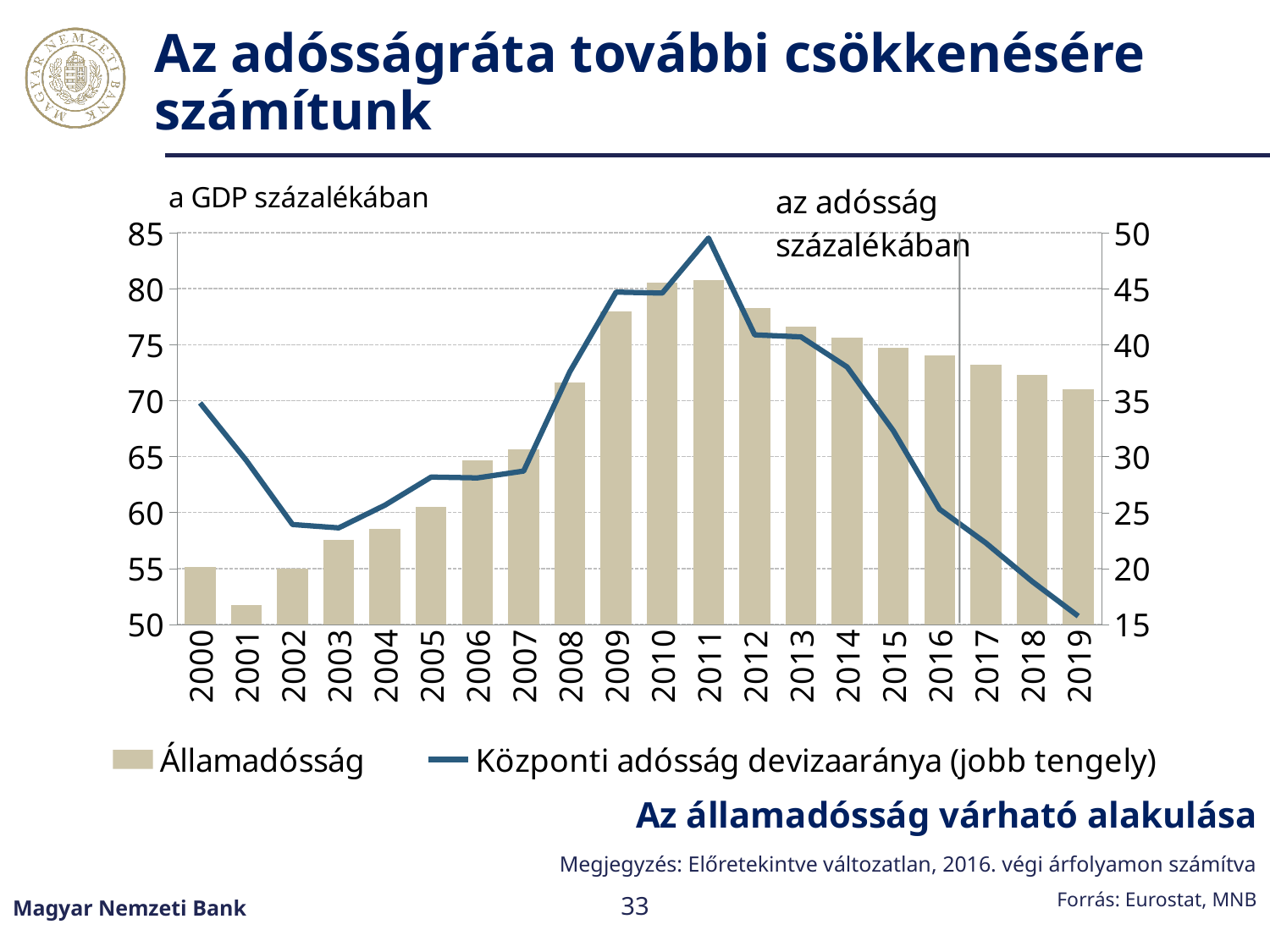
What is the label of the left vertical axis? a GDP százalékában Which year has the larger Államadósság bar, 2008 or 2013? 2013 Is the Államadósság value for 2001 greater or less than 55? less How many series does the legend list? 2 Which year has the lowest Államadósság bar? 2001 What kind of chart is shown on the slide? A combined bar and line chart How many years are shown on the x axis? 20 Do the Államadósság bars rise or fall from 2011 to 2019? fall Is the Központi adósság devizaaránya value for 2019 greater or less than 20 on the right axis? less In which year is the Központi adósság devizaaránya line at its lowest? 2019 In which year does the Központi adósság devizaaránya line reach its highest point? 2011 Is the Államadósság value for 2010 greater or less than 80? greater